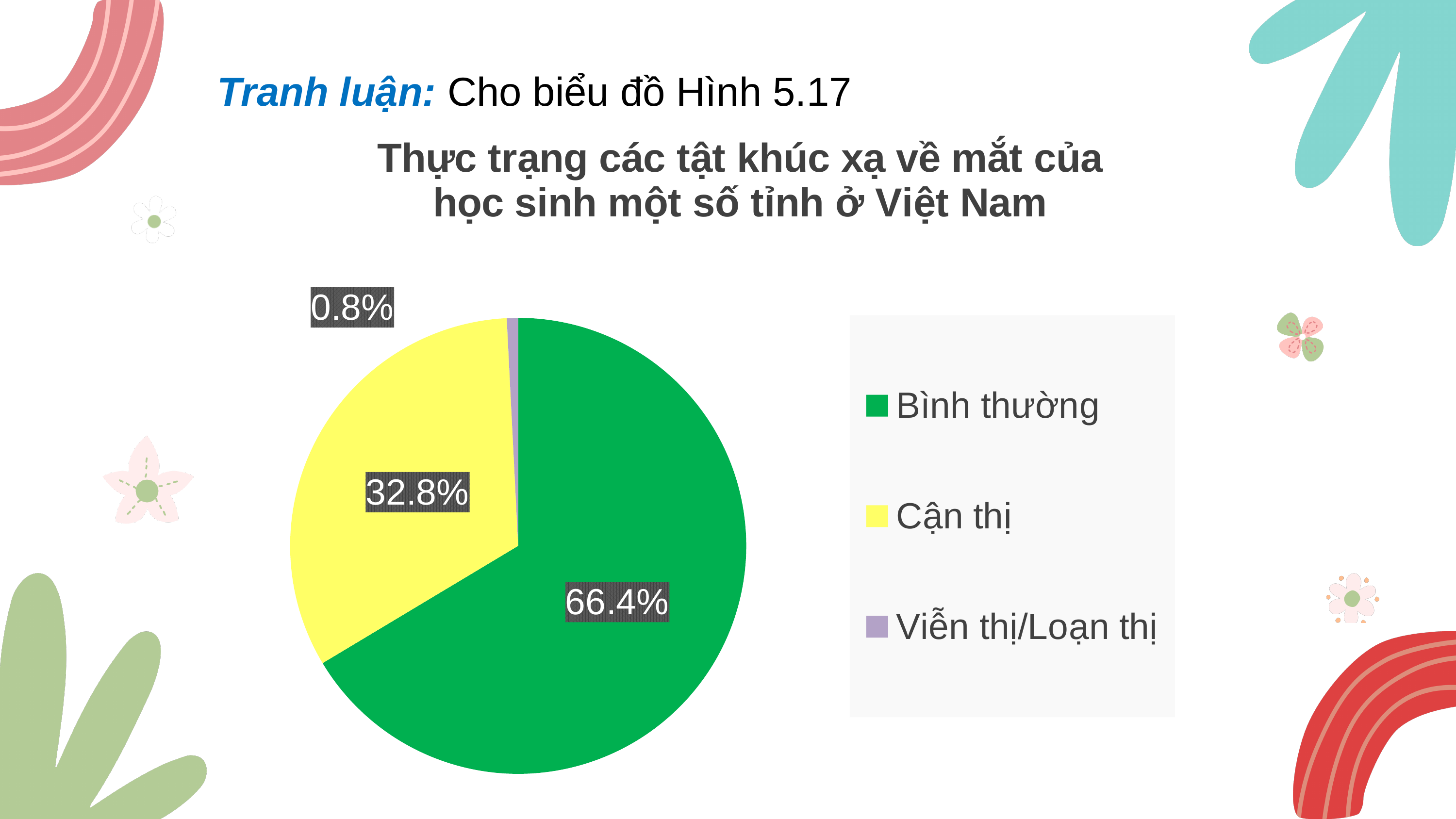
How many categories does the pie chart show? 3 How many entries does the legend list? 3 What is the title of the chart? Thực trạng các tật khúc xạ về mắt của học sinh một số tỉnh ở Việt Nam What percentage of the pie is labelled for Bình thường? 66.4% What colour is the slice for Cận thị? yellow Which category has the smallest slice of the pie? Viễn thị/Loạn thị What is the difference in percentage points between Bình thường and Cận thị? 33.6 What percentage of the pie is labelled for Cận thị? 32.8% Which is larger, the slice for Cận thị or the slice for Viễn thị/Loạn thị? Cận thị What kind of chart is shown on the slide? pie chart What percentage of the pie is labelled for Viễn thị/Loạn thị? 0.8% Which category has the largest slice of the pie? Bình thường